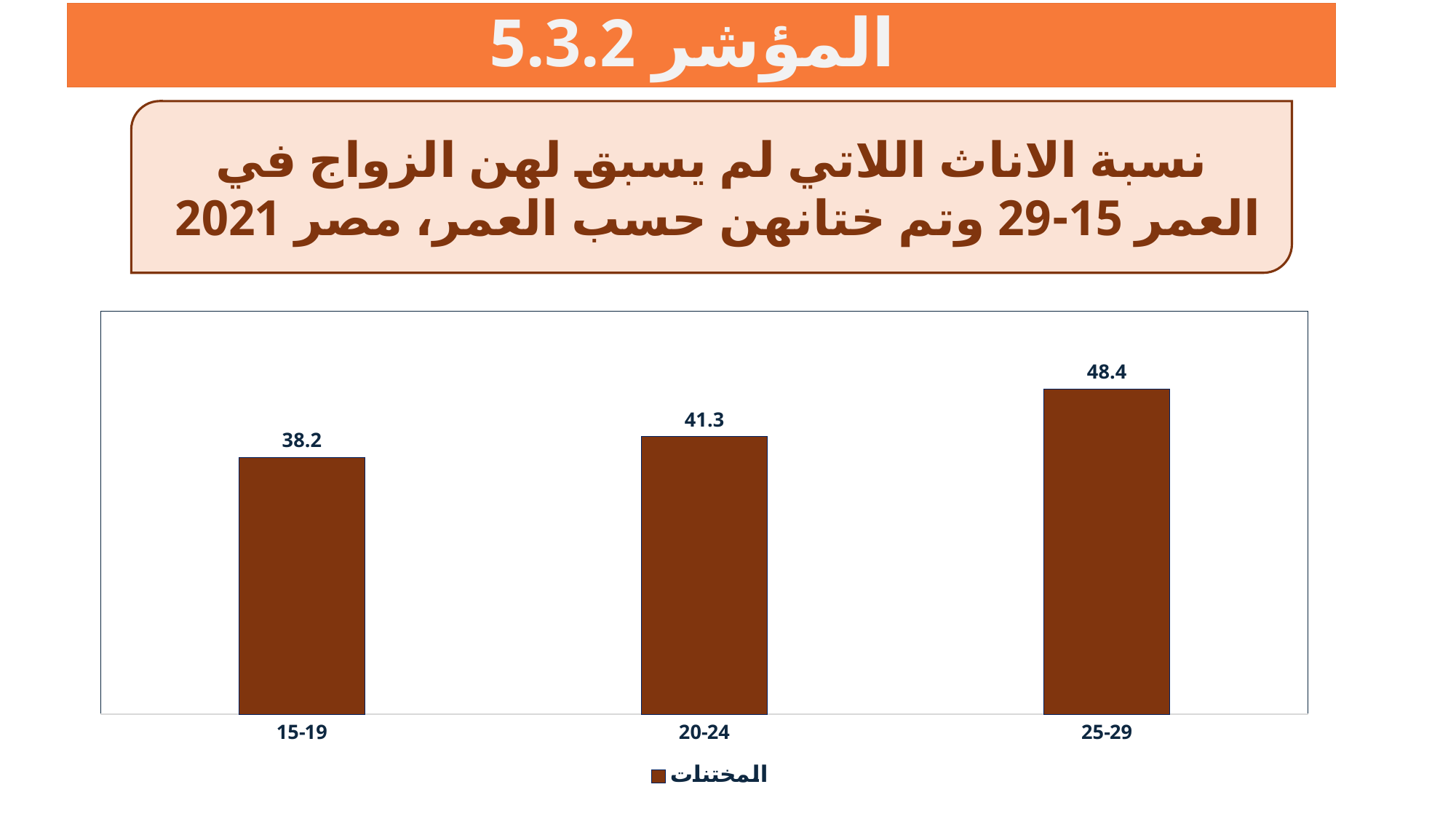
Which is larger, the value for 20-24 or the value for 25-29? 25-29 What is the value for the 20-24 age group? 41.3 Do the values rise or fall as the age group increases from 15-19 to 25-29? Rise What is the value for the 25-29 age group? 48.4 What is the difference between the values for 25-29 and 15-19? 10.2 Which age group has the lowest value? 15-19 How many series does the legend list? 1 Which age group has the highest value? 25-29 What kind of chart is shown on the slide? Bar chart What is the value for the 15-19 age group? 38.2 How many age groups are shown in the chart? 3 What is the difference between the values for 20-24 and 15-19? 3.1